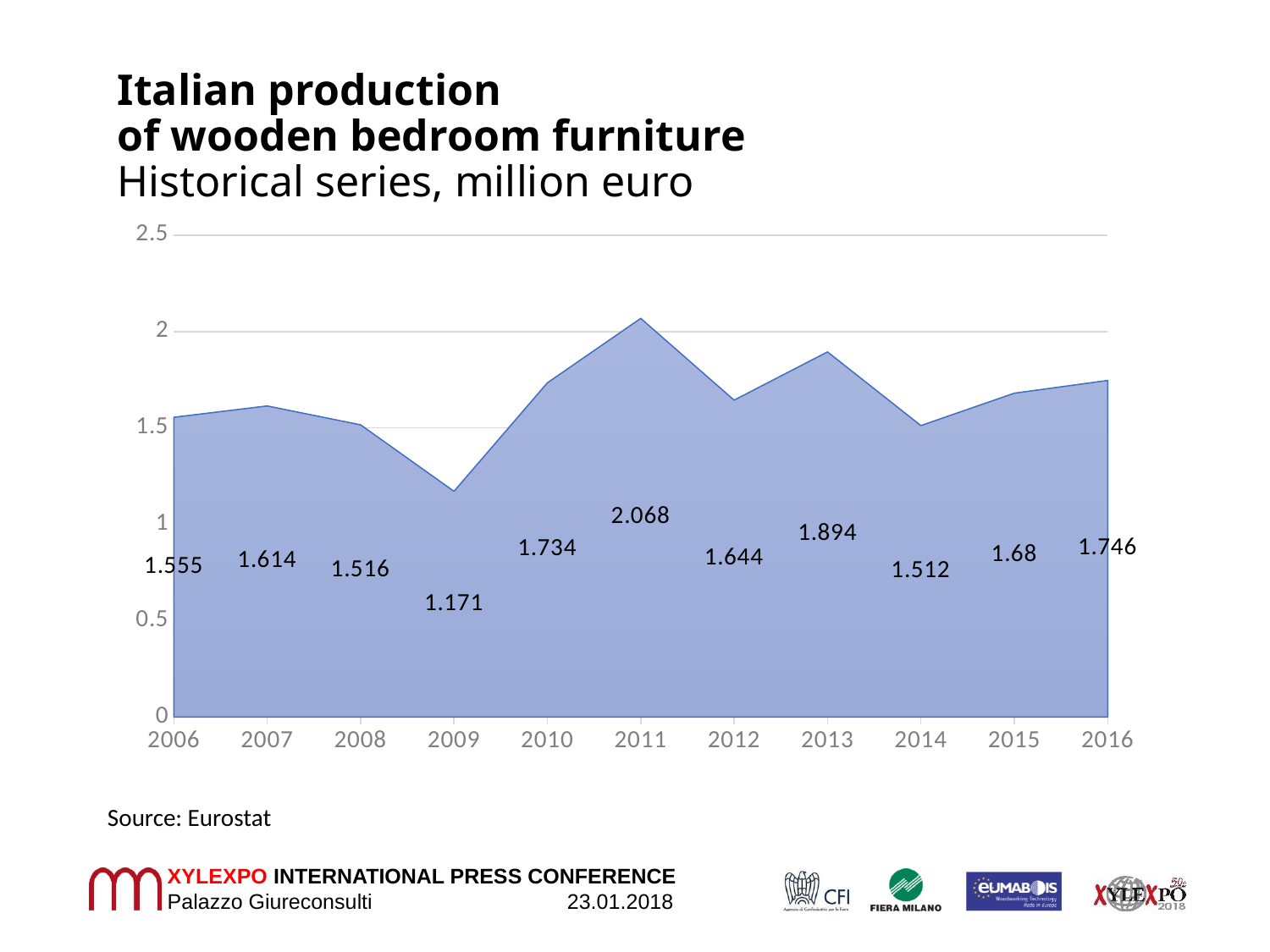
What is the difference between the values for 2013 and 2012? 0.25 What is the value for 2015? 1.68 Which year has the lowest value? 2009 What is the value for 2009? 1.171 What kind of chart is shown on the slide? area chart What is the value for 2011? 2.068 What is the value for 2016? 1.746 Which year has the highest value? 2011 How many years are plotted on the chart? 11 Which is larger, the value for 2007 or the value for 2014? 2007 What is the difference between the values for 2011 and 2009? 0.897 Is the value for 2013 greater or less than 1.5? greater